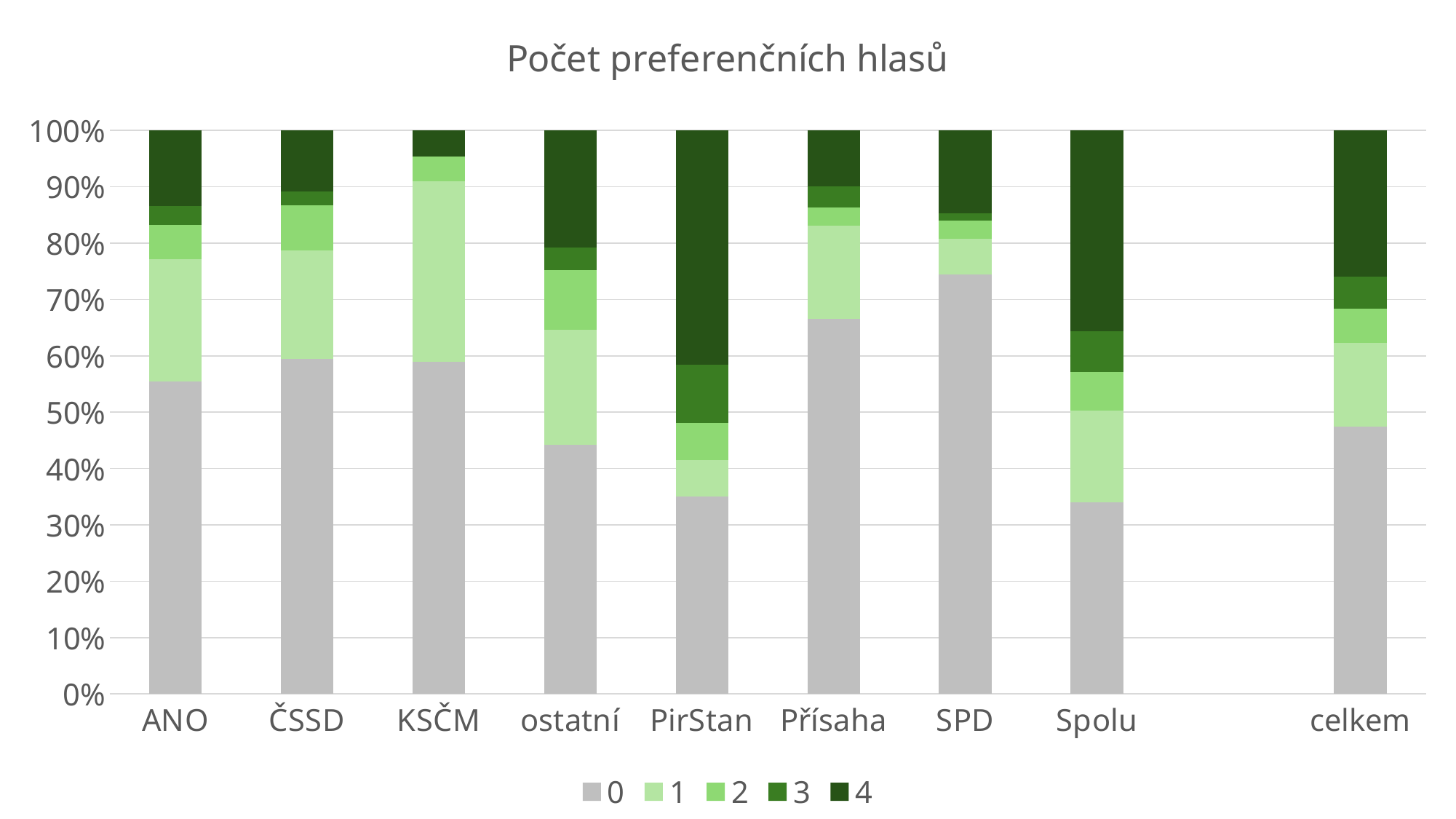
Is the share of series 0 for PirStan greater or less than 40%? less Which has a larger share of series 4, ostatní or KSČM? ostatní How many categories are shown on the x axis? 9 What kind of chart is shown on the slide? stacked bar chart Is the share of series 0 for SPD greater or less than 70%? greater How many series does the legend list? 5 Which category has the largest share for series 4? PirStan Is the share of series 0 for celkem greater or less than 50%? less What is the title of the chart? Počet preferenčních hlasů Which category has the smallest share for series 4? KSČM Which category has the largest share for series 0? SPD Which has a larger share of series 0, SPD or Spolu? SPD